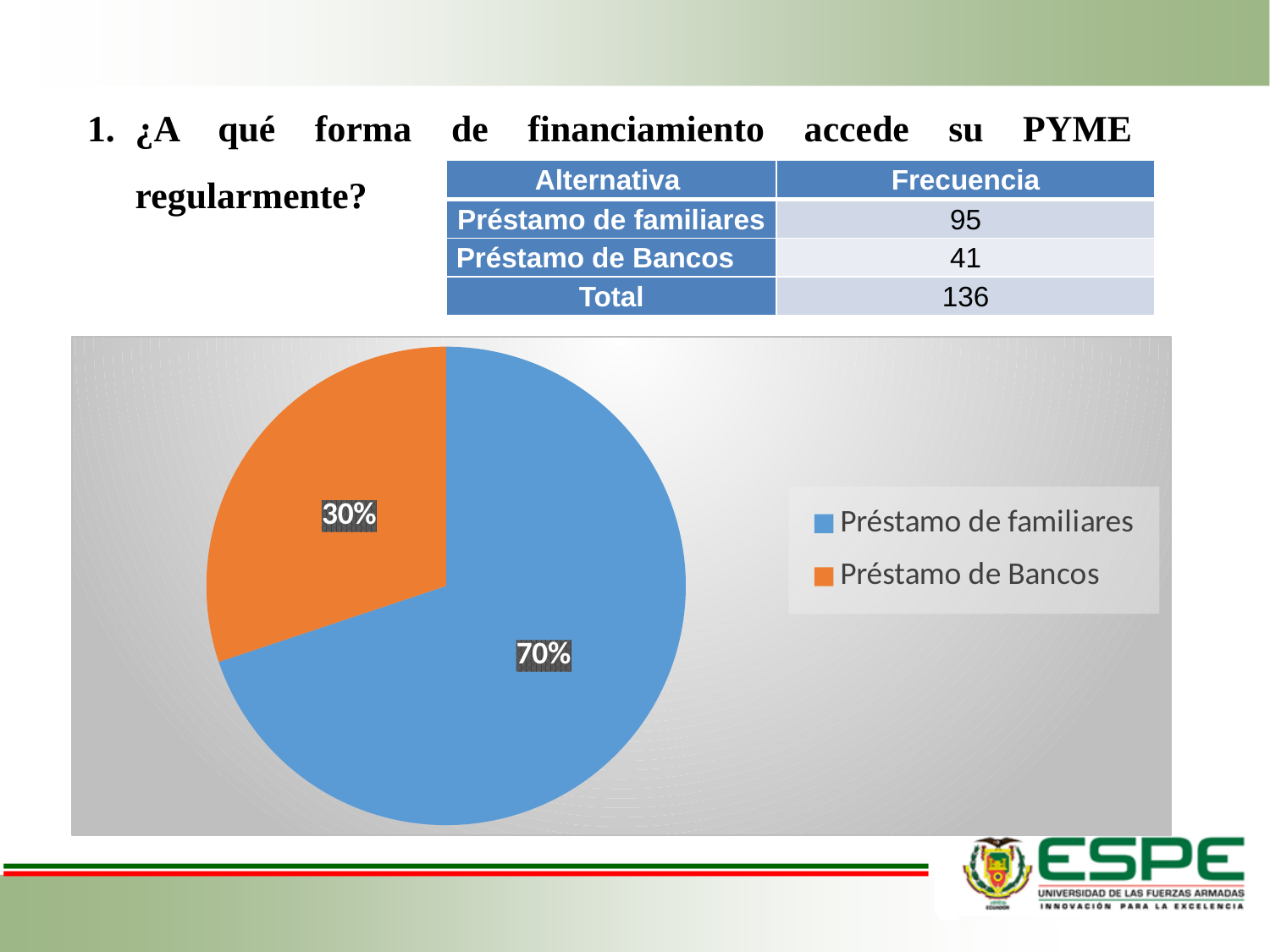
What is the difference in percentage points between the Préstamo de familiares slice and the Préstamo de Bancos slice? 40% What share of the pie does Préstamo de familiares represent? 70% Which slice is larger, Préstamo de familiares or Préstamo de Bancos? Préstamo de familiares What share of the pie does Préstamo de Bancos represent? 30% What colour is the Préstamo de familiares slice? blue How many entries does the legend list? 2 Which category has the smallest slice of the pie? Préstamo de Bancos What kind of chart is shown on the slide? pie chart How many slices does the pie chart have? 2 Which category has the largest slice of the pie? Préstamo de familiares What colour is the Préstamo de Bancos slice? orange